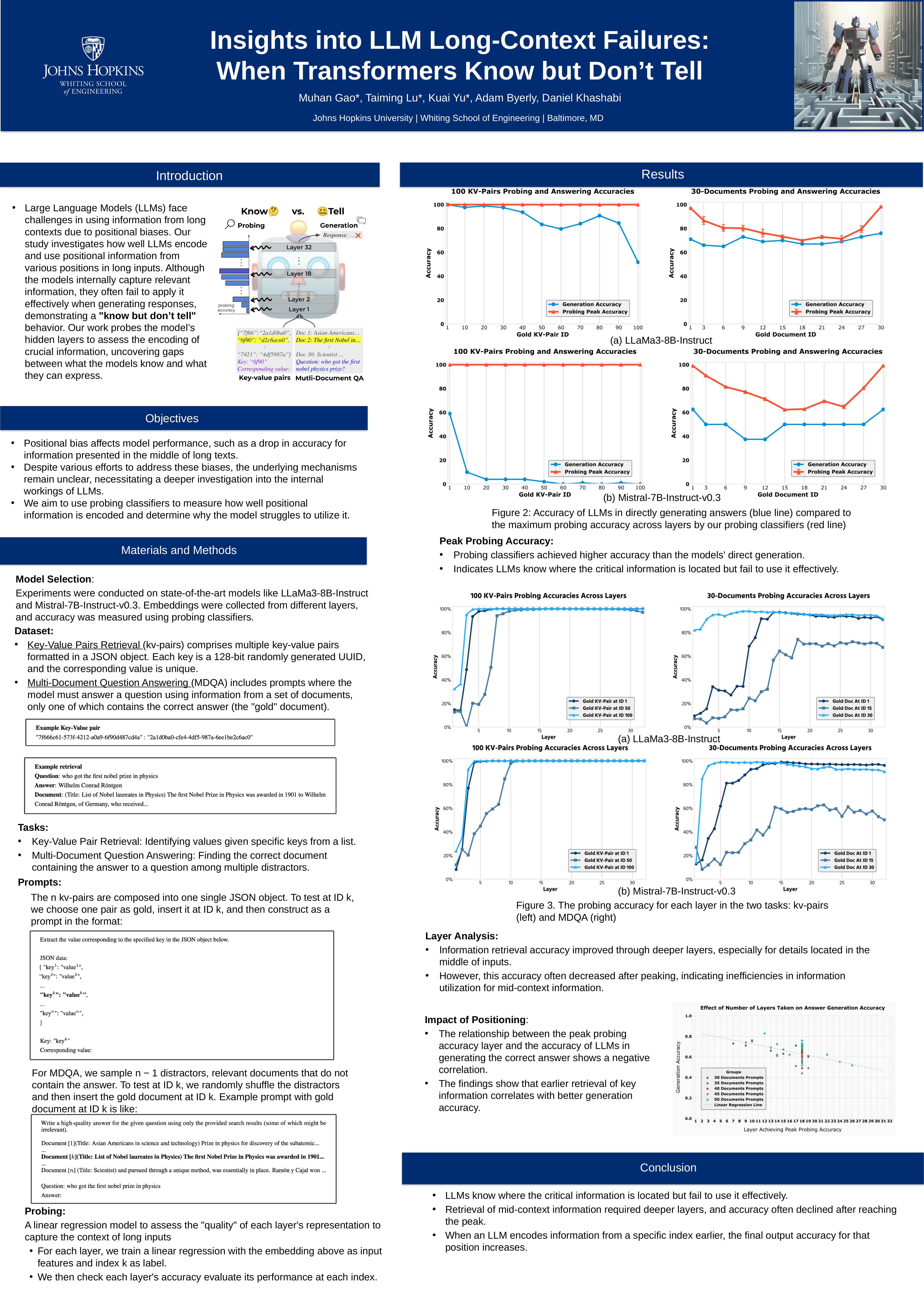
In the scatter chart titled "Effect of Number of Layers Taken on Answer Generation Accuracy", how many entries does the Groups legend list? 6 In the "100 KV-Pairs Probing and Answering Accuracies" chart for Mistral-7B-Instruct-v0.3 (Figure 2b, left), what is the Probing Peak Accuracy at Gold KV-Pair ID 50? 100 In the "100 KV-Pairs Probing and Answering Accuracies" chart for LLaMa3-8B-Instruct (Figure 2a, left), at which Gold KV-Pair ID is the Generation Accuracy lowest? 100 In the "100 KV-Pairs Probing and Answering Accuracies" chart for LLaMa3-8B-Instruct (Figure 2a, left), which series is higher at Gold KV-Pair ID 100, Generation Accuracy or Probing Peak Accuracy? Probing Peak Accuracy In the "100 KV-Pairs Probing and Answering Accuracies" chart for LLaMa3-8B-Instruct (Figure 2a, left), how many Gold KV-Pair ID points are plotted along the x axis? 11 In the chart titled "100 KV-Pairs Probing and Answering Accuracies" for LLaMa3-8B-Instruct (Figure 2a, left), how many series does the legend list? 2 In the "30-Documents Probing Accuracies Across Layers" chart for LLaMa3-8B-Instruct (Figure 3a, right), what are the three legend entries? Gold Doc At ID 1, Gold Doc At ID 15, Gold Doc At ID 30 What kind of chart is the "30-Documents Probing and Answering Accuracies" chart for LLaMa3-8B-Instruct (Figure 2a, right)? line chart In the "100 KV-Pairs Probing and Answering Accuracies" chart for Mistral-7B-Instruct-v0.3 (Figure 2b, left), is the Generation Accuracy at Gold KV-Pair ID 1 greater or less than 40? greater In the "30-Documents Probing and Answering Accuracies" chart for Mistral-7B-Instruct-v0.3 (Figure 2b, right), is the Probing Peak Accuracy at Gold Document ID 15 greater or less than 80? less In the "100 KV-Pairs Probing and Answering Accuracies" chart for Mistral-7B-Instruct-v0.3 (Figure 2b, left), does the Generation Accuracy rise or fall as the Gold KV-Pair ID increases from 1 to 10? fall In the "100 KV-Pairs Probing and Answering Accuracies" chart for Mistral-7B-Instruct-v0.3 (Figure 2b, left), is the Generation Accuracy at Gold KV-Pair ID 50 greater or less than 20? less